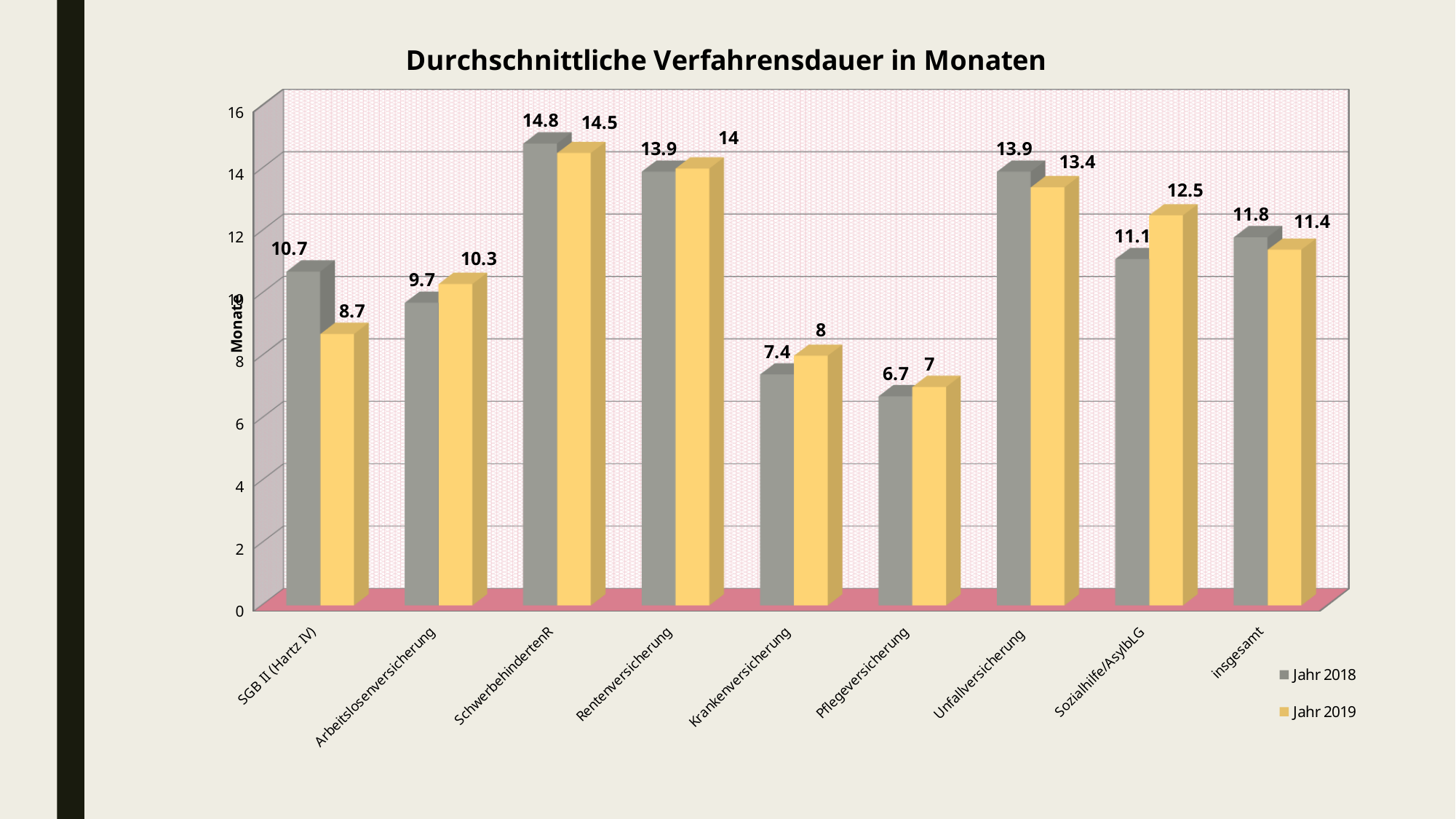
Which category has the lowest value in Jahr 2019? Pflegeversicherung How many categories are shown on the x axis? 9 What is the value for Sozialhilfe/AsylbLG in Jahr 2019? 12.5 What is the difference between the Jahr 2018 and Jahr 2019 values for SGB II (Hartz IV)? 2 Which is larger for Arbeitslosenversicherung: the Jahr 2018 value or the Jahr 2019 value? Jahr 2019 What is the value for SGB II (Hartz IV) in Jahr 2019? 8.7 What is the value for Unfallversicherung in Jahr 2018? 13.9 What kind of chart is shown on the slide? Bar chart How many series does the legend list? 2 What is the title of the chart? Durchschnittliche Verfahrensdauer in Monaten Which category has the highest value in Jahr 2018? SchwerbehindertenR What is the value for insgesamt in Jahr 2018? 11.8